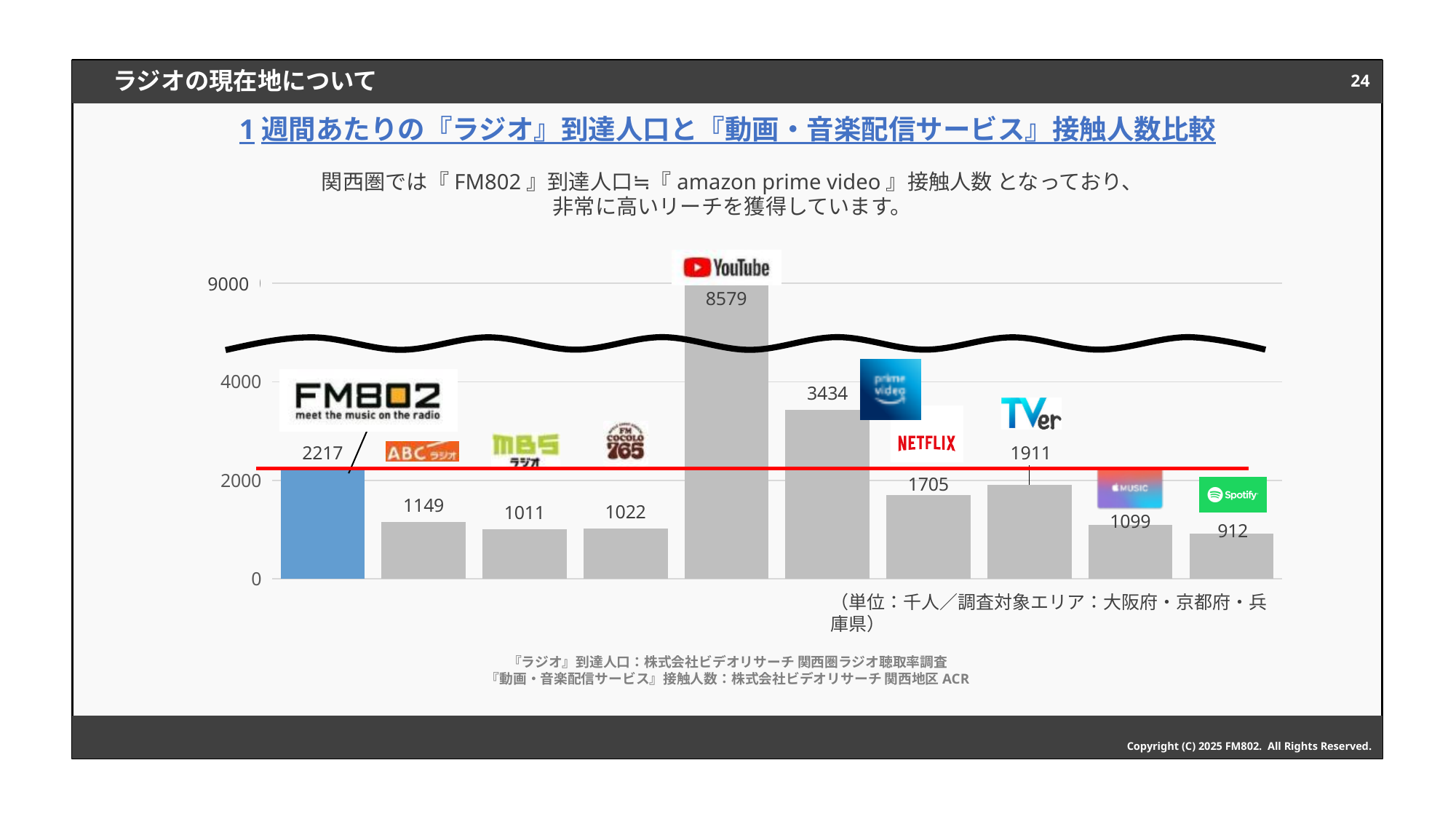
Which category has the highest value? YouTube What is the value for prime video? 3434 What kind of chart is shown on the slide? bar chart Which is larger, the value for FM802 or the value for TVer? FM802 How many bars are plotted in the chart? 10 What is the value for TVer? 1911 What unit is stated for the values in the chart? 千人 What is the value for YouTube? 8579 What is the value for Spotify? 912 Which category has the lowest value? Spotify What is the difference between the values for prime video and FM802? 1217 What is the value for FM802? 2217